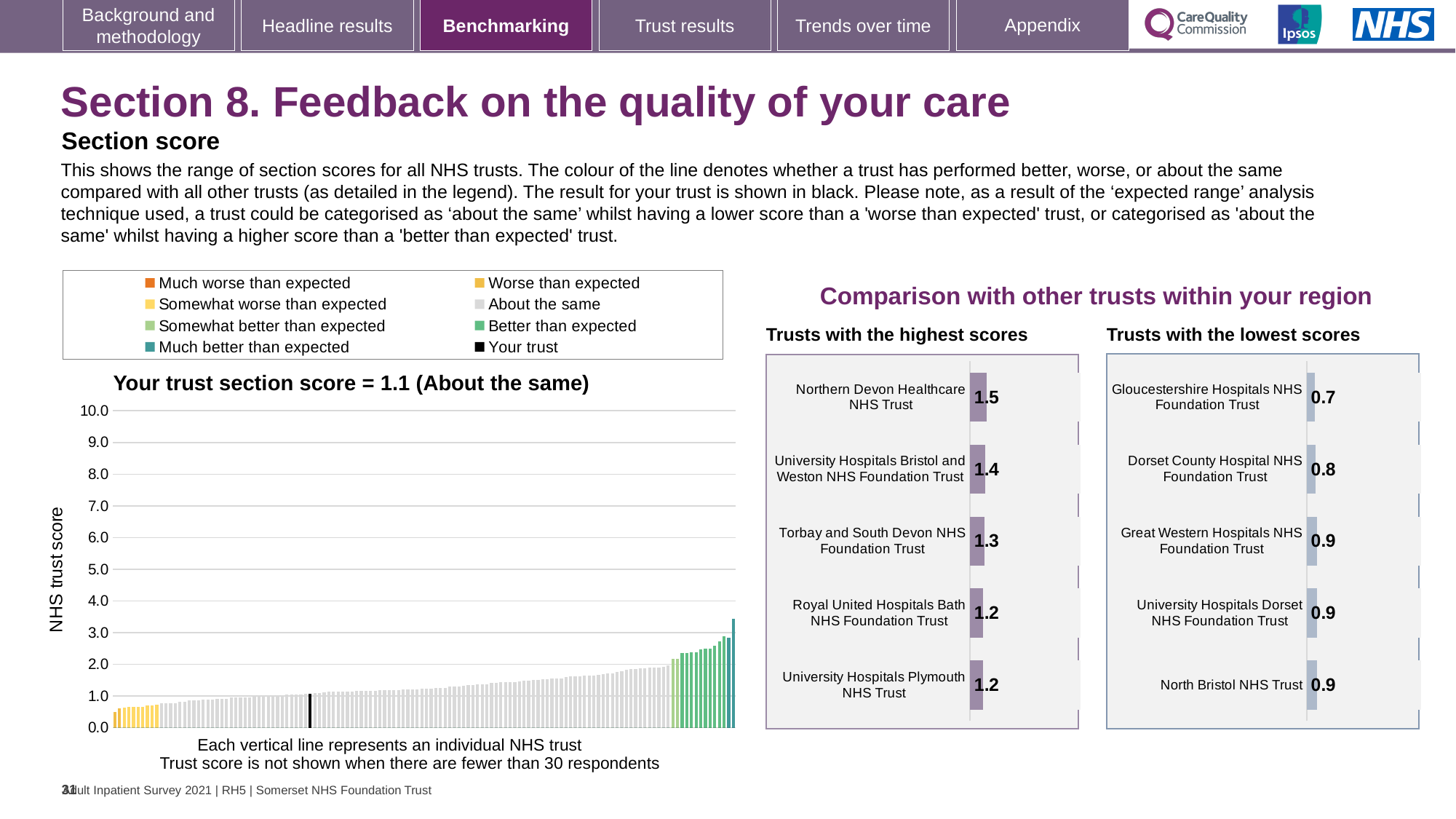
In the 'Your trust section score' chart, is the value of the tallest bar greater or less than 4.0? less In the 'Trusts with the highest scores' chart, what is the score for Torbay and South Devon NHS Foundation Trust? 1.3 What kind of chart is the 'Your trust section score' chart? bar chart In the 'Trusts with the lowest scores' chart, which has the larger score: Dorset County Hospital NHS Foundation Trust or Gloucestershire Hospitals NHS Foundation Trust? Dorset County Hospital NHS Foundation Trust In the 'Trusts with the highest scores' chart, what is the difference between the scores of Northern Devon Healthcare NHS Trust and Torbay and South Devon NHS Foundation Trust? 0.2 In the 'Your trust section score' chart, what is the section score for your trust? 1.1 In the 'Your trust section score' chart, do the trust scores rise or fall from left to right along the x axis? rise In the 'Trusts with the lowest scores' chart, which trust has the lowest score? Gloucestershire Hospitals NHS Foundation Trust How many entries does the legend above the 'Your trust section score' chart list? 8 In the 'Trusts with the highest scores' chart, how many trusts are shown? 5 In the 'Trusts with the highest scores' chart, which trust has the highest score? Northern Devon Healthcare NHS Trust In the 'Trusts with the lowest scores' chart, what is the score for Dorset County Hospital NHS Foundation Trust? 0.8